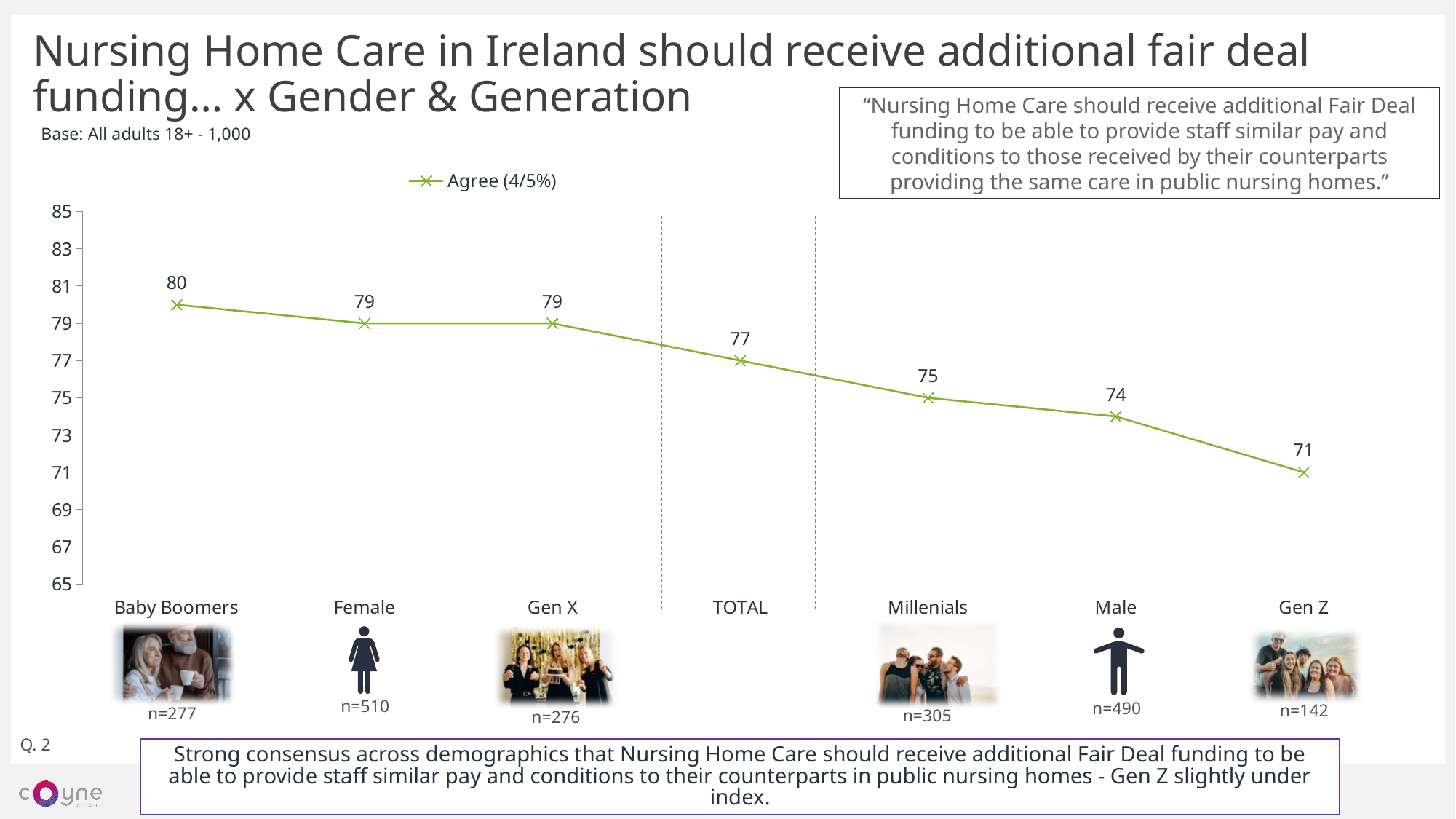
What is the Agree (4/5%) value for Gen Z? 71 Which category has the highest Agree (4/5%) value? Baby Boomers What is the Agree (4/5%) value for TOTAL? 77 What is the Agree (4/5%) value for Baby Boomers? 80 How many categories are plotted on the x axis? 7 Which category has the lowest Agree (4/5%) value? Gen Z What is the difference between the Agree (4/5%) values for Baby Boomers and Gen Z? 9 What kind of chart is shown on the slide? Line chart Which has a higher Agree (4/5%) value, Female or Male? Female How many series does the legend list? 1 What is the Agree (4/5%) value for Male? 74 Do the Agree (4/5%) values rise or fall from left to right along the x axis? Fall